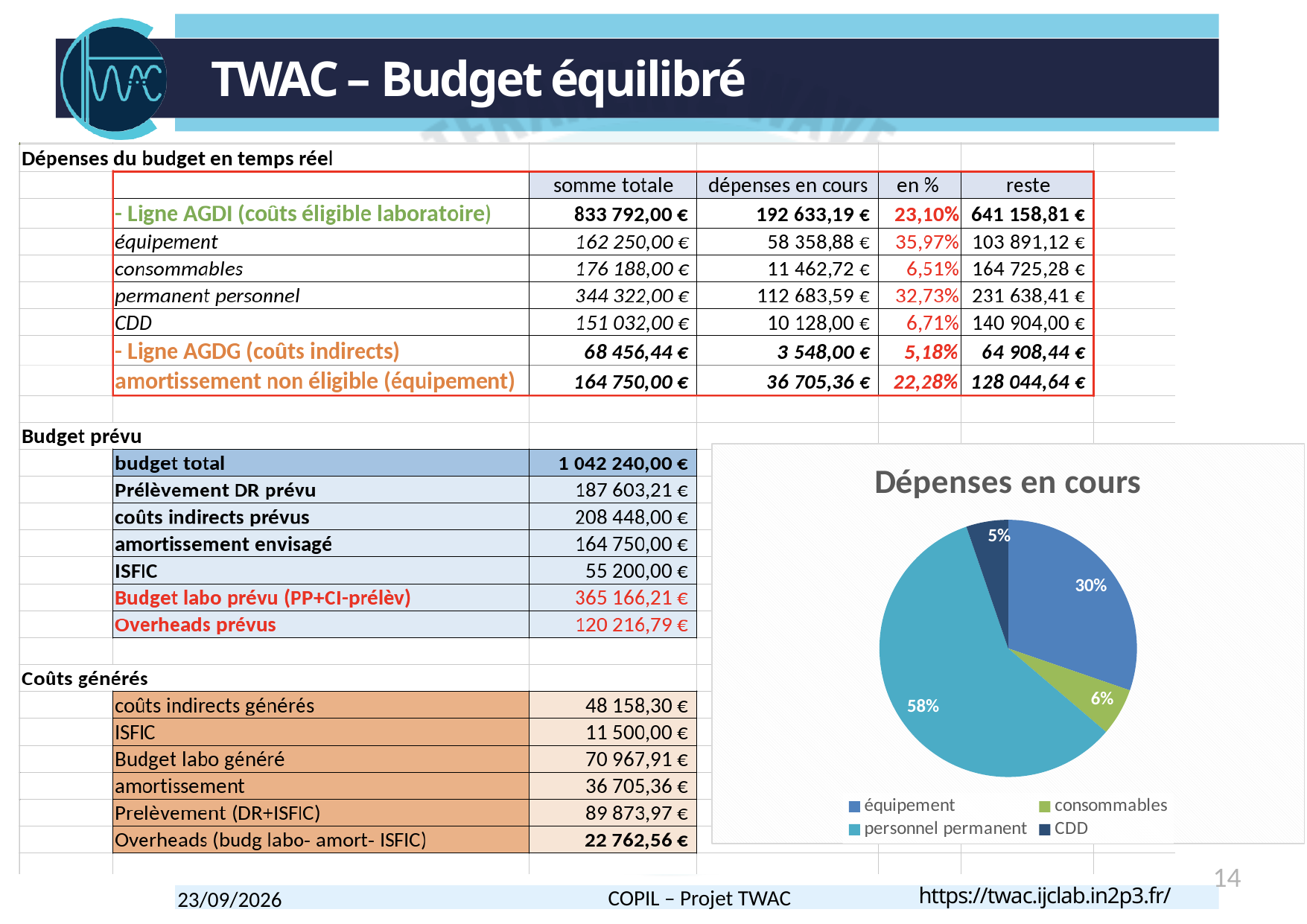
What share of the pie does équipement represent? 30% What share of the pie does CDD represent? 5% What share of the pie does personnel permanent represent? 58% How many entries does the chart legend list? 4 What is the title of the chart? Dépenses en cours How many slices does the pie chart have? 4 Which category has the largest slice of the pie? personnel permanent Which category has the smallest slice of the pie? CDD What kind of chart is shown on the slide? pie chart What is the difference in percentage points between the personnel permanent slice and the équipement slice? 28% Which is larger in the pie chart, équipement or consommables? équipement